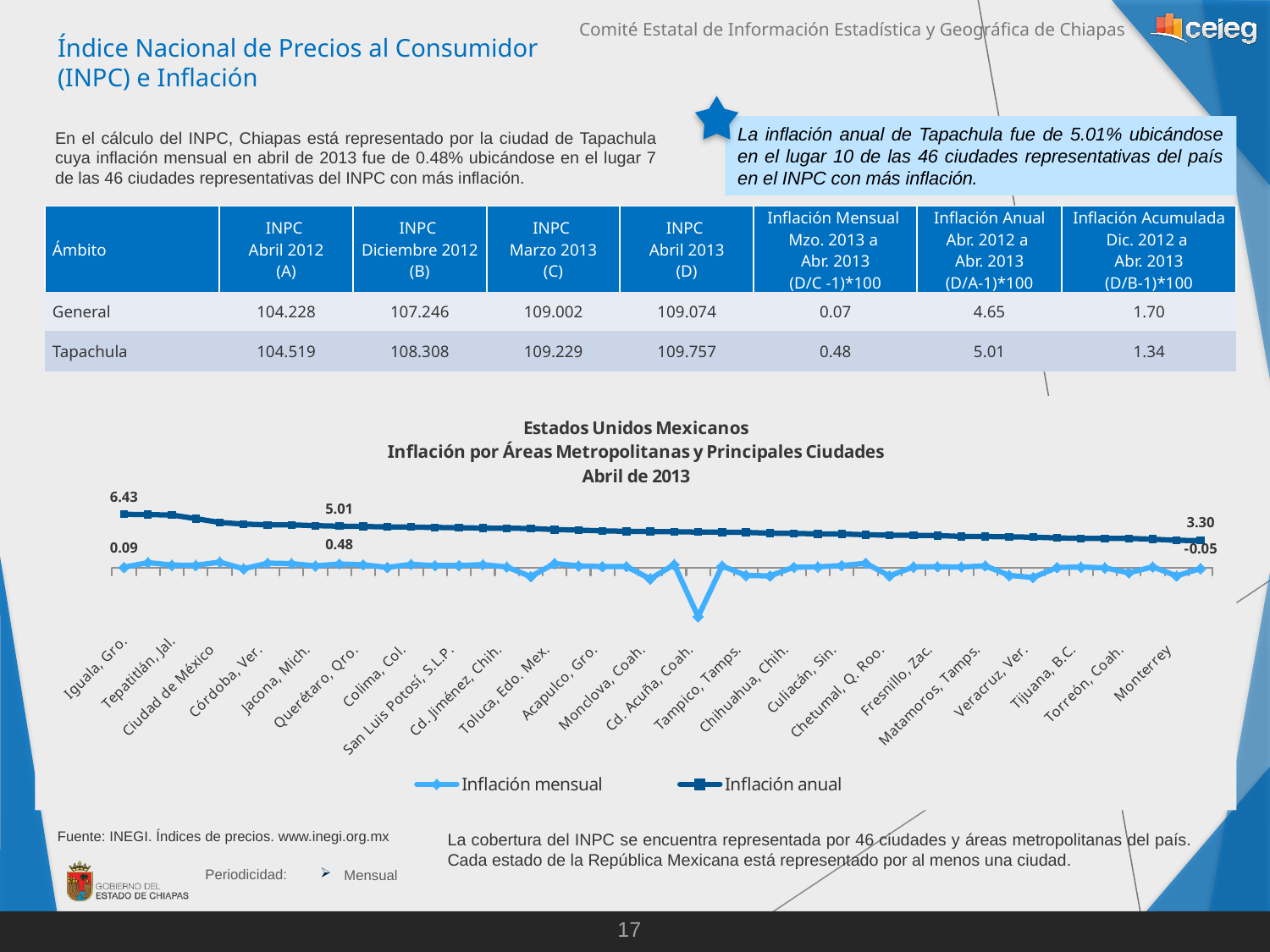
What is the Inflación mensual value labeled at the first point of the chart (Iguala, Gro.)? 0.09 What are the two series named in the chart legend? Inflación mensual and Inflación anual What is the Inflación anual value labeled at the first point of the chart (Iguala, Gro.)? 6.43 What is the title of the chart? Estados Unidos Mexicanos Inflación por Áreas Metropolitanas y Principales Ciudades Abril de 2013 Which city has the highest Inflación anual value in the chart? Iguala, Gro. How many series does the chart legend list? 2 What type of chart is shown on the slide? Line chart At the first point of the chart, which is larger: the Inflación anual value or the Inflación mensual value? Inflación anual Does the Inflación anual line rise or fall from left to right along the x axis? Fall What is the difference between the Inflación anual values labeled at the first point (6.43) and the last point (3.30)? 3.13